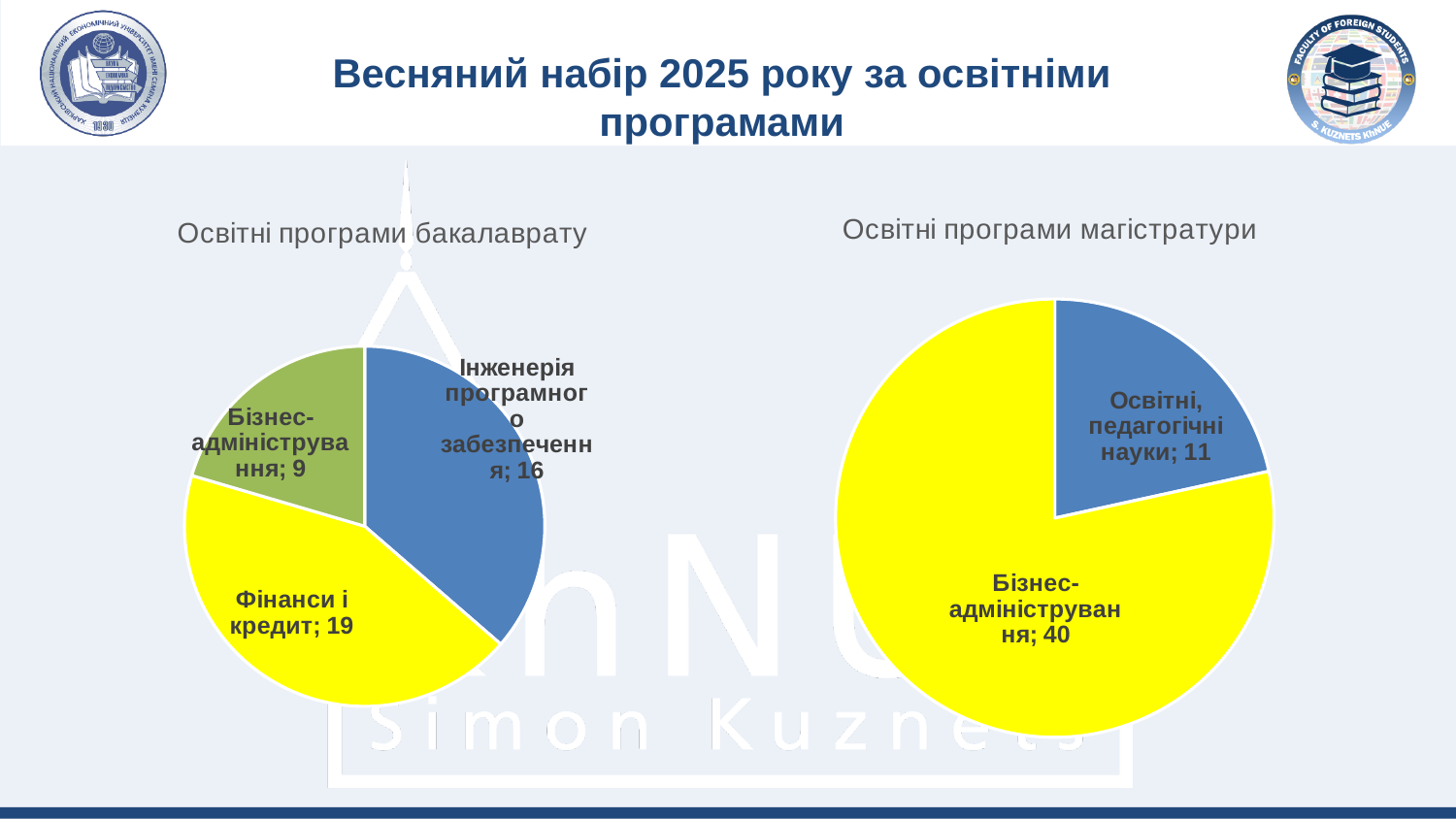
In the chart titled 'Освітні програми бакалаврату', what is the value for 'Фінанси і кредит'? 19 In the chart titled 'Освітні програми бакалаврату', which category has the largest value? Фінанси і кредит What kind of chart is the chart titled 'Освітні програми магістратури'? Pie chart In the chart titled 'Освітні програми бакалаврату', what is the value for 'Інженерія програмного забезпечення'? 16 In the chart titled 'Освітні програми бакалаврату', which category has the smallest value? Бізнес-адміністрування In the chart titled 'Освітні програми бакалаврату', what is the difference between 'Фінанси і кредит' and 'Бізнес-адміністрування'? 10 In the chart titled 'Освітні програми магістратури', what is the value for 'Освітні, педагогічні науки'? 11 In the chart titled 'Освітні програми магістратури', what is the total of all slices? 51 In the chart titled 'Освітні програми магістратури', what is the difference between 'Бізнес-адміністрування' and 'Освітні, педагогічні науки'? 29 In the chart titled 'Освітні програми бакалаврату', which is larger: 'Інженерія програмного забезпечення' or 'Бізнес-адміністрування'? Інженерія програмного забезпечення In the chart titled 'Освітні програми магістратури', what is the value for 'Бізнес-адміністрування'? 40 How many categories does the chart titled 'Освітні програми бакалаврату' show? 3